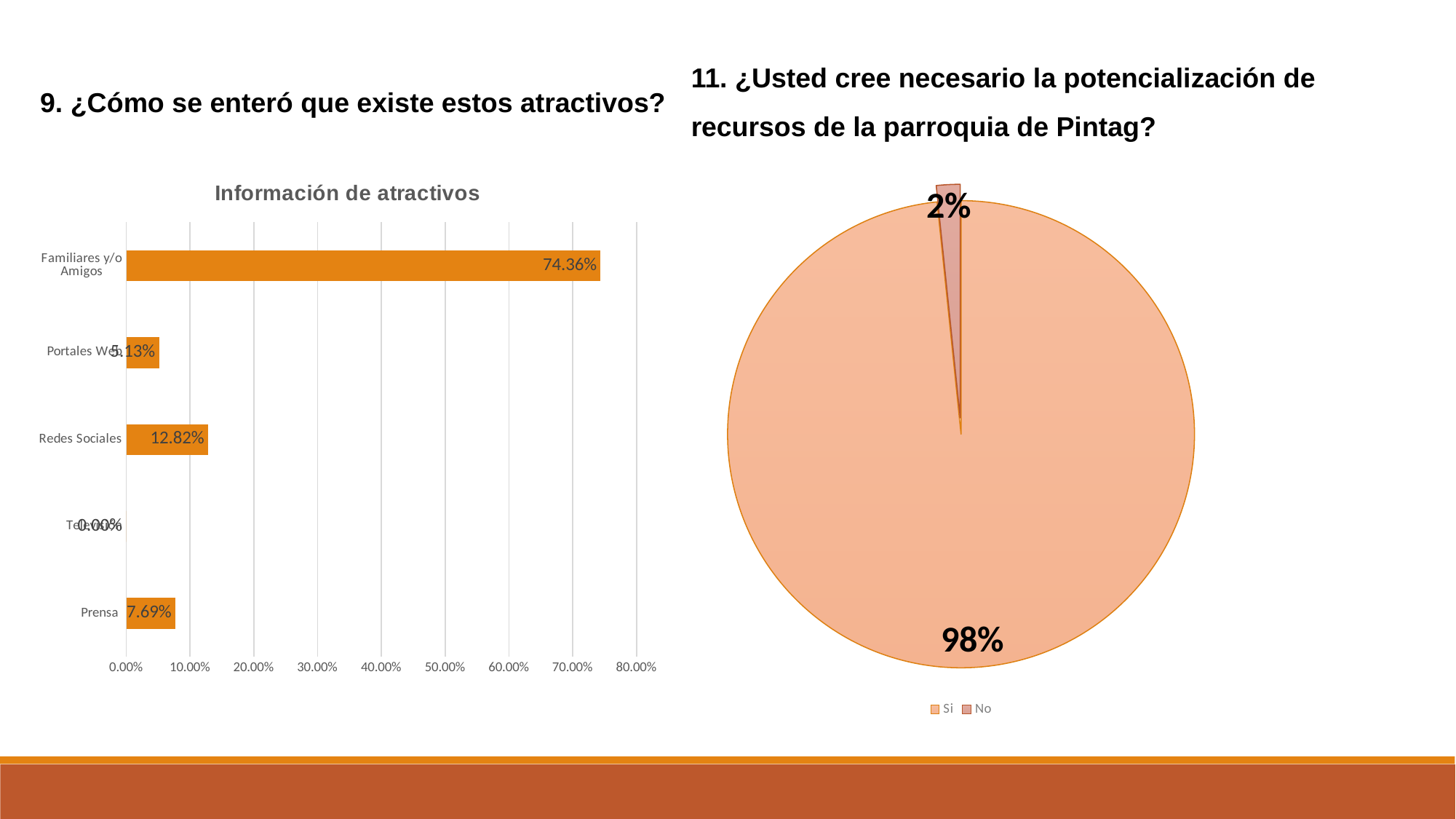
In the 'Información de atractivos' chart, what is the value for Familiares y/o Amigos? 74.36% In the pie chart on the right, what share of responses is 'No'? 2% In the 'Información de atractivos' chart, is the value for Familiares y/o Amigos greater or less than 70.00%? greater How many categories are shown in the 'Información de atractivos' chart? 5 In the 'Información de atractivos' chart, which is larger, Redes Sociales or Prensa? Redes Sociales In the 'Información de atractivos' chart, what is the difference between Redes Sociales and Prensa? 5.13% In the 'Información de atractivos' chart, what is the value for Redes Sociales? 12.82% What kind of chart is the 'Información de atractivos' chart? bar chart In the 'Información de atractivos' chart, which category has the highest value? Familiares y/o Amigos In the pie chart on the right, what share of responses is 'Si'? 98% In the 'Información de atractivos' chart, what is the value for Prensa? 7.69% How many entries does the legend of the pie chart on the right list? 2